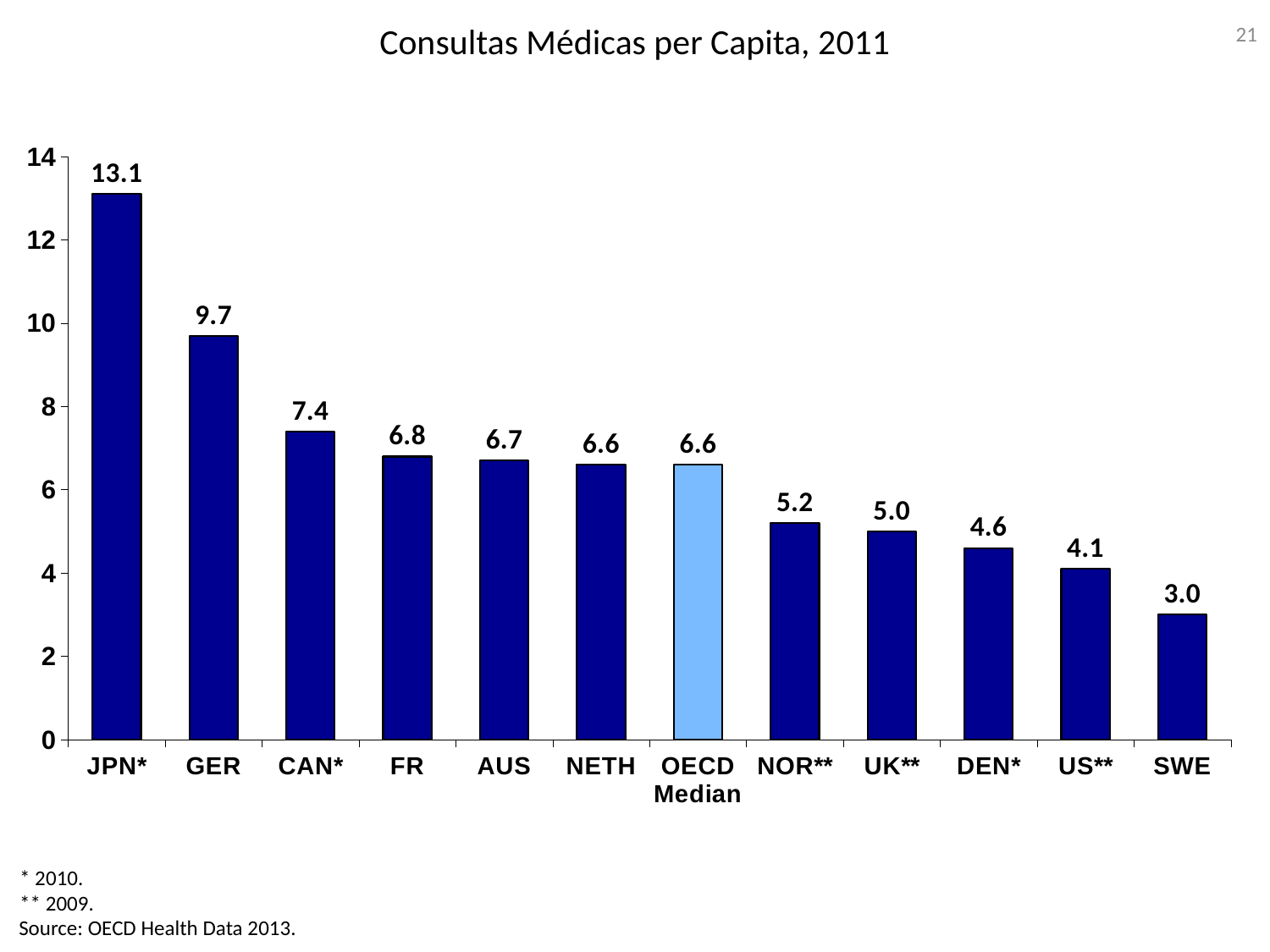
What is the value for SWE? 3.0 Is the value for CAN* greater or less than 8? less Do the values rise or fall from left to right along the x axis? fall What kind of chart is shown on the slide? bar chart Which category has the lowest value? SWE What is the title of the chart? Consultas Médicas per Capita, 2011 What is the value for the OECD Median bar? 6.6 What is the value for JPN* in the chart? 13.1 How many bars are shown in the chart? 12 Which is larger, the value for NOR** or the value for UK**? NOR** Which category has the highest value? JPN* What is the difference between the values for JPN* and GER? 3.4